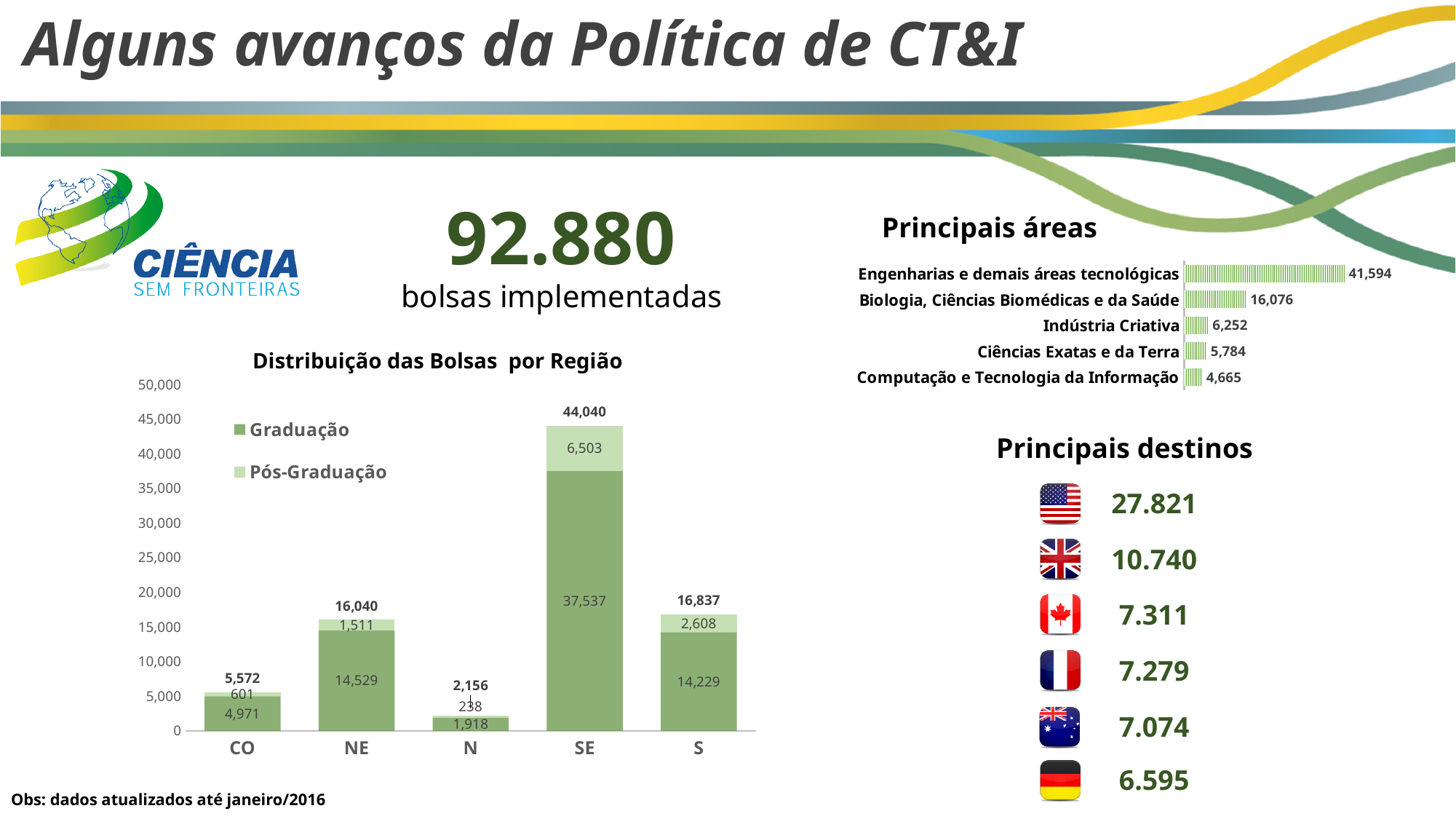
In the chart 'Distribuição das Bolsas por Região', which region has the highest total? SE In the chart 'Distribuição das Bolsas por Região', what is the difference between the Graduação values for NE and S? 300 In the chart 'Distribuição das Bolsas por Região', how many regions are shown on the x axis? 5 In the chart 'Distribuição das Bolsas por Região', how many series does the legend list? 2 In the 'Principais áreas' chart, which area has the highest value? Engenharias e demais áreas tecnológicas In the chart 'Distribuição das Bolsas por Região', what is the Graduação value for SE? 37,537 In the chart 'Distribuição das Bolsas por Região', what is the total of the stacked bar for NE? 16,040 In the chart 'Distribuição das Bolsas por Região', is the Pós-Graduação value larger for NE or for S? S What kind of chart is 'Distribuição das Bolsas por Região'? Stacked bar chart In the chart 'Distribuição das Bolsas por Região', what is the Pós-Graduação value for S? 2,608 In the 'Principais áreas' chart, what is the value for Indústria Criativa? 6,252 In the chart 'Distribuição das Bolsas por Região', which region has the lowest total? N